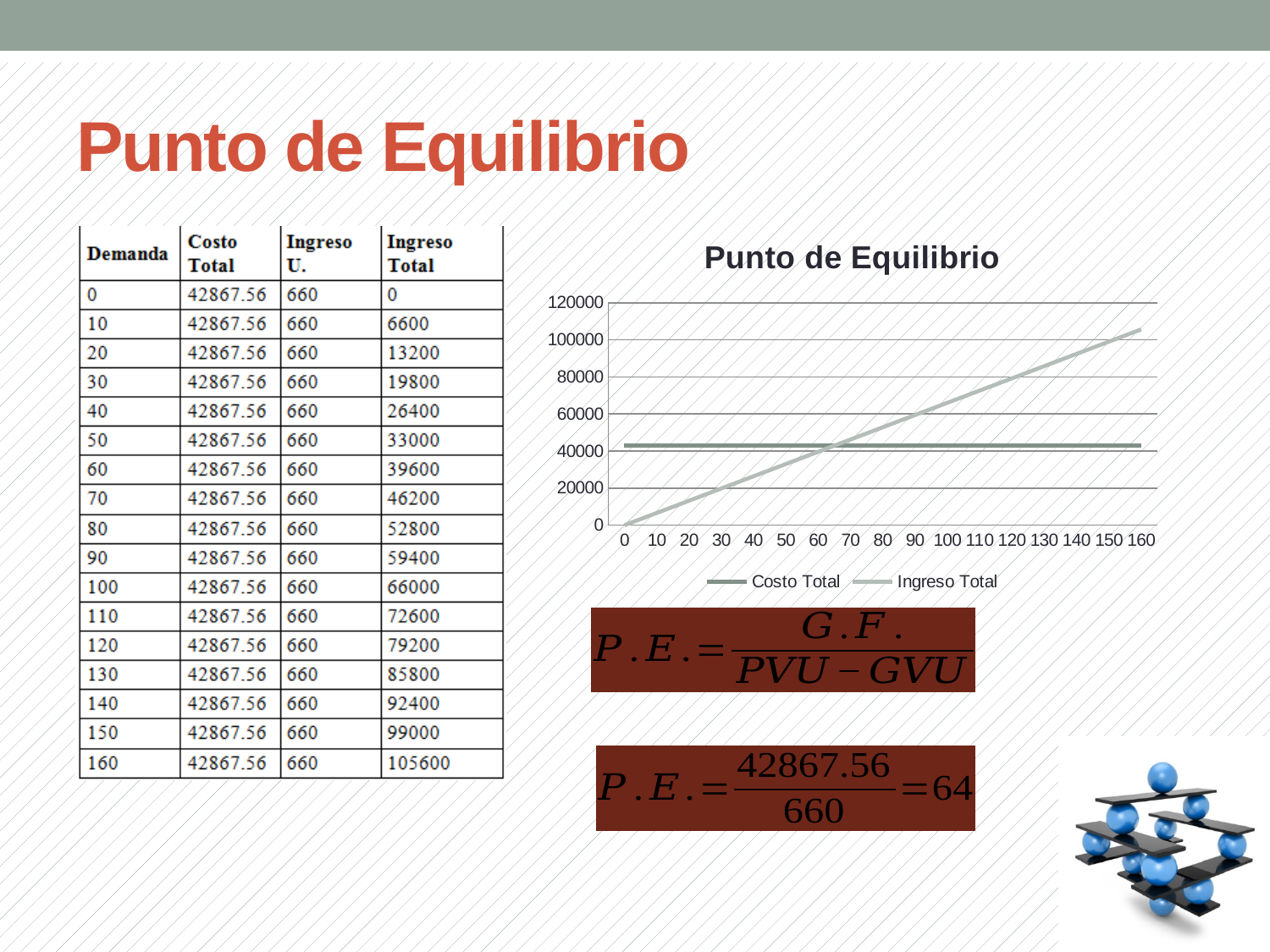
Does the Ingreso Total line rise or fall as demand increases along the x axis? rises What are the two series named in the chart legend? Costo Total and Ingreso Total Does the Costo Total line rise, fall or stay flat along the x axis? stays flat How many series does the legend of the chart list? 2 Is the value of Ingreso Total at a demand of 160 greater or less than 100000? greater Is the value of Ingreso Total at a demand of 20 greater or less than 20000? less What kind of chart is shown on the slide? line chart At a demand of 160, which series has the larger value, Costo Total or Ingreso Total? Ingreso Total Is the value of Costo Total at a demand of 100 greater or less than 60000? less What is the title of the chart? Punto de Equilibrio What is the value of Ingreso Total at a demand of 0? 0 At a demand of 20, which series has the larger value, Costo Total or Ingreso Total? Costo Total